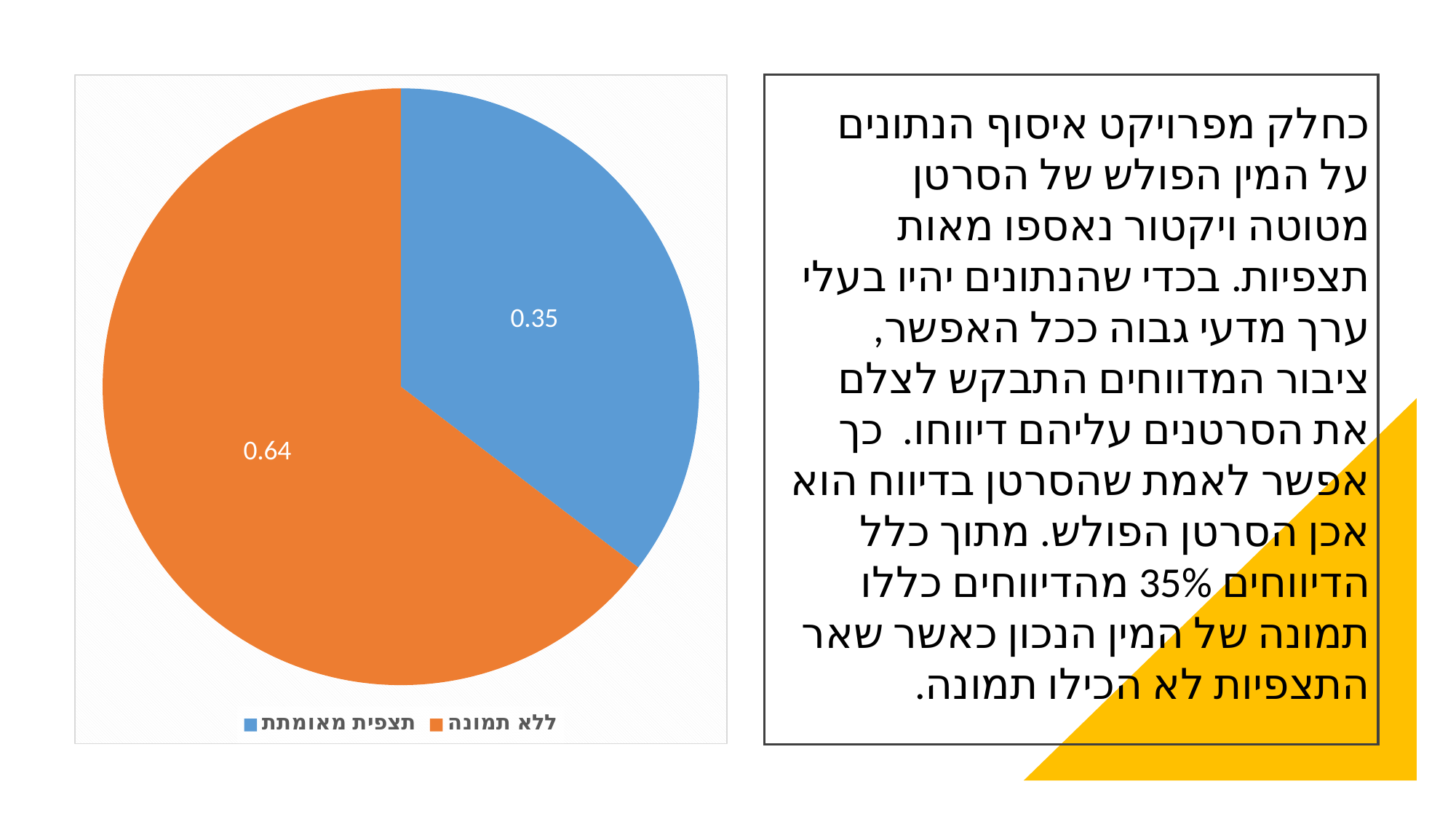
What is the difference between the values for ללא תמונה and תצפית מאומתת? 0.29 How many slices does the pie chart have? 2 Which is larger, the slice for ללא תמונה or the slice for תצפית מאומתת? ללא תמונה What is the value shown for the slice labelled ללא תמונה? 0.64 What type of chart is shown on the slide? pie chart How many entries does the legend list? 2 What is the value shown for the slice labelled תצפית מאומתת? 0.35 What colour is the slice for ללא תמונה? orange What colour is the slice for תצפית מאומתת? blue Which slice of the pie chart is the largest? ללא תמונה What share of the pie does the ללא תמונה slice represent, as labelled on the chart? 0.64 Which slice of the pie chart is the smallest? תצפית מאומתת